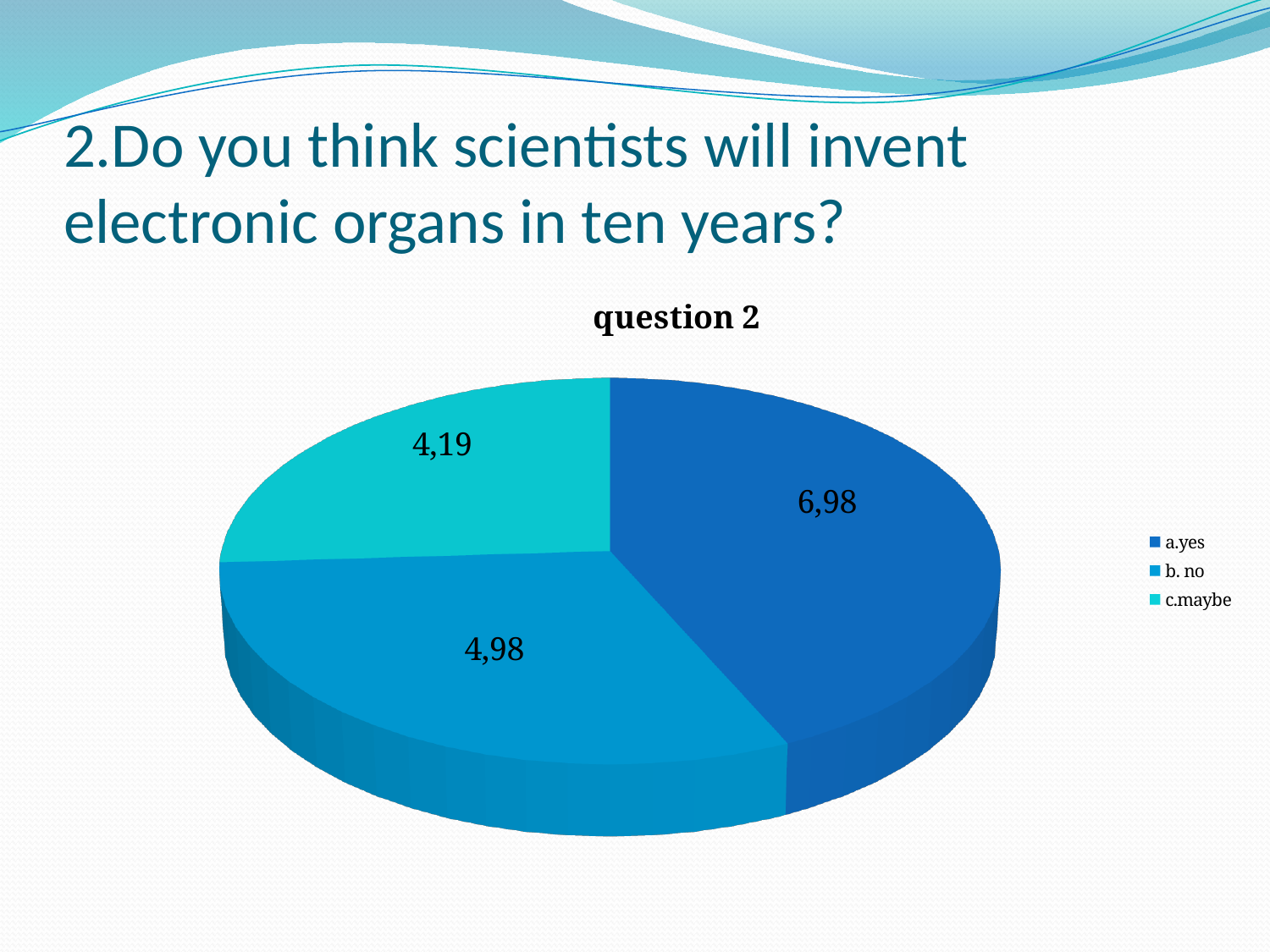
What is the difference between the values for a.yes and b. no? 2,00 What is the title of the chart? question 2 Which is larger, the value for b. no or the value for c.maybe? b. no What is the difference between the values for b. no and c.maybe? 0,79 Which category has the largest slice of the pie? a.yes Which category has the smallest slice of the pie? c.maybe What type of chart is shown on the slide? pie chart How many entries does the legend list? 3 How many slices does the pie chart have? 3 What is the value for c.maybe? 4,19 What is the value for b. no? 4,98 What is the value for a.yes? 6,98